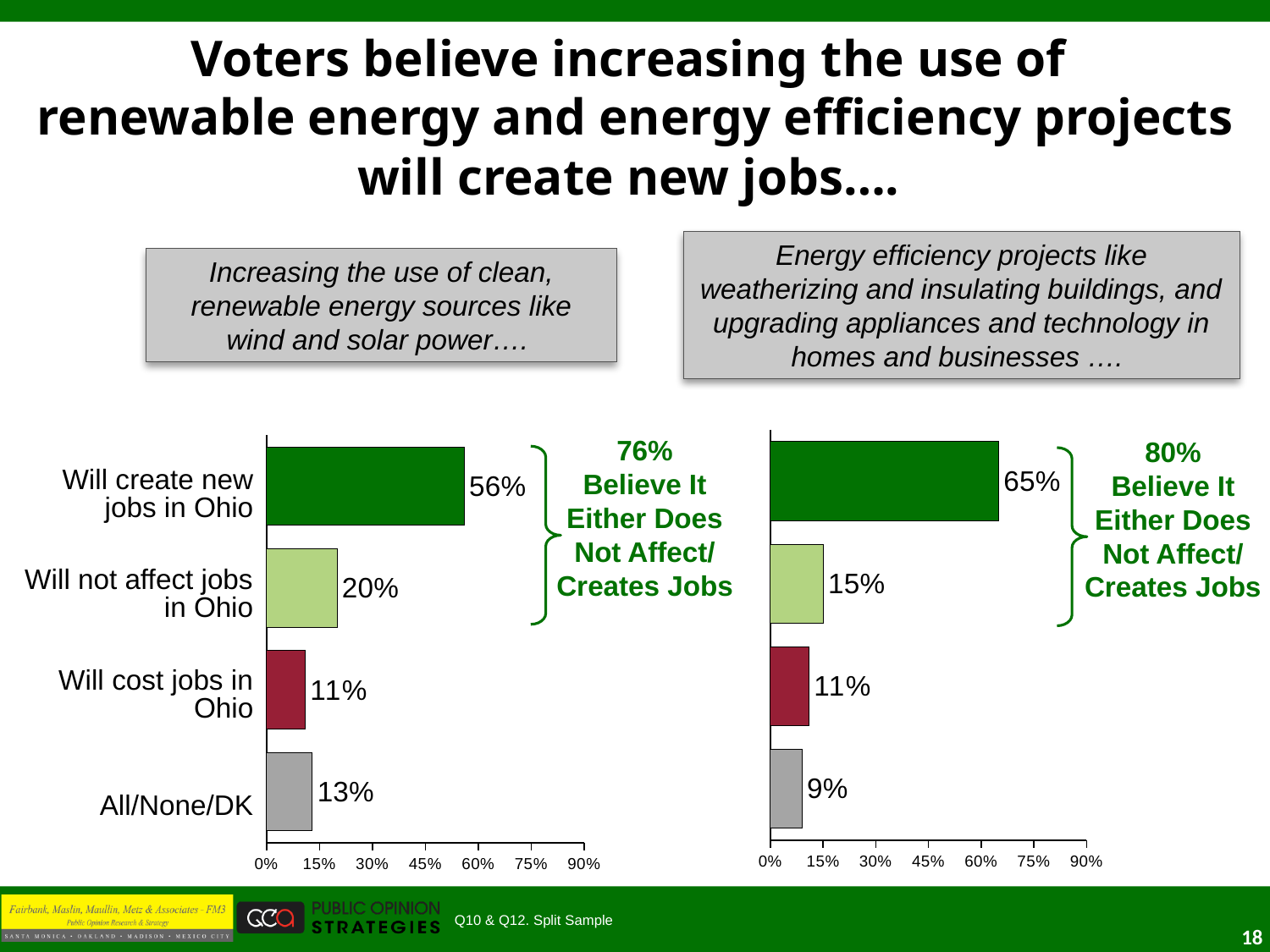
What type of chart is used on this slide? Bar chart In the left chart (clean, renewable energy), what is the difference between 'Will create new jobs in Ohio' and 'Will not affect jobs in Ohio'? 36 percentage points In the left chart (clean, renewable energy), what percentage say it will create new jobs in Ohio? 56% In the left chart (clean, renewable energy), which response has the lowest percentage? Will cost jobs in Ohio In the right chart (energy efficiency projects), which response has the highest percentage? Will create new jobs in Ohio In the right chart (energy efficiency projects), what percentage say it will create new jobs in Ohio? 65% Which is larger: the 'Will not affect jobs in Ohio' value in the left chart (renewable energy) or in the right chart (energy efficiency)? Left chart (renewable energy), 20% What is the difference between the 'Will create new jobs in Ohio' percentages in the right chart (energy efficiency) and the left chart (renewable energy)? 9 percentage points How many response categories are shown in each chart? 4 According to the annotation next to the right chart (energy efficiency projects), what percentage believe it either does not affect or creates jobs? 80% In the right chart (energy efficiency projects), what percentage answered All/None/DK? 9% In the left chart (clean, renewable energy), what percentage say it will not affect jobs in Ohio? 20%